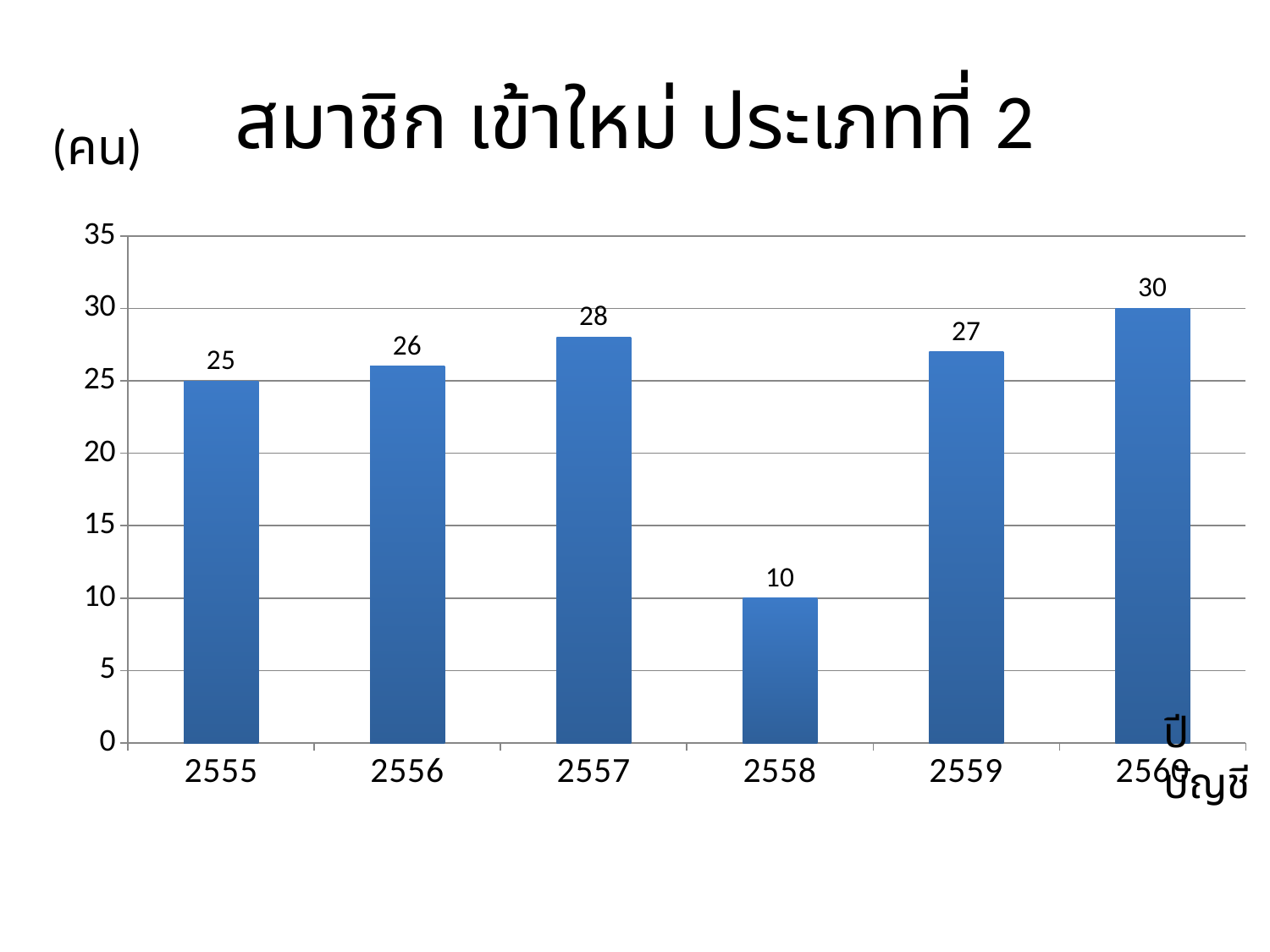
What kind of chart is shown on the slide? bar chart How many years are shown on the x axis? 6 Is the value for 2558 greater or less than 15? less Which year has the highest value? 2560 What is the difference between the values for 2557 and 2556? 2 What is the difference between the values for 2560 and 2558? 20 Which year has the lowest value? 2558 What is the value for 2560? 30 What is the title of the chart? สมาชิก เข้าใหม่ ประเภทที่ 2 Which is larger, the value for 2557 or the value for 2559? 2557 What is the value for 2558? 10 What is the value for 2555? 25